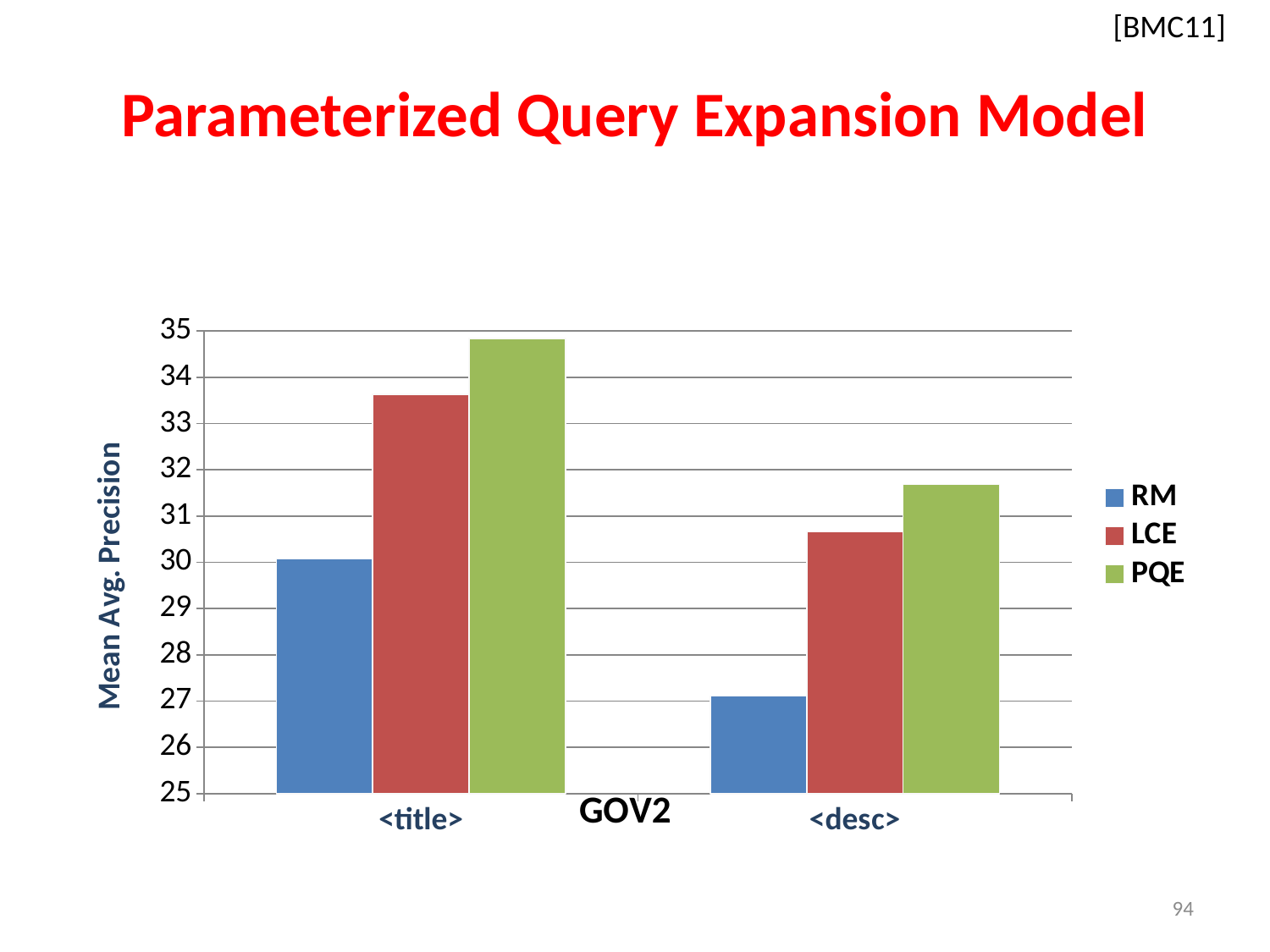
What kind of chart is shown on the slide? bar chart Which series has the lowest bar in the <desc> category? RM Which series has the highest bar in the <title> category? PQE Is the value for PQE in the <desc> category greater or less than 32? less How many categories are shown on the x axis? 2 Is the value for PQE in the <title> category greater or less than 34? greater How many series does the legend list? 3 Is the value for LCE in the <title> category greater or less than 33? greater What is the label of the y axis? Mean Avg. Precision Do the values for each series rise or fall from <title> to <desc>? fall Which is larger: LCE in the <title> category or PQE in the <desc> category? LCE in <title>